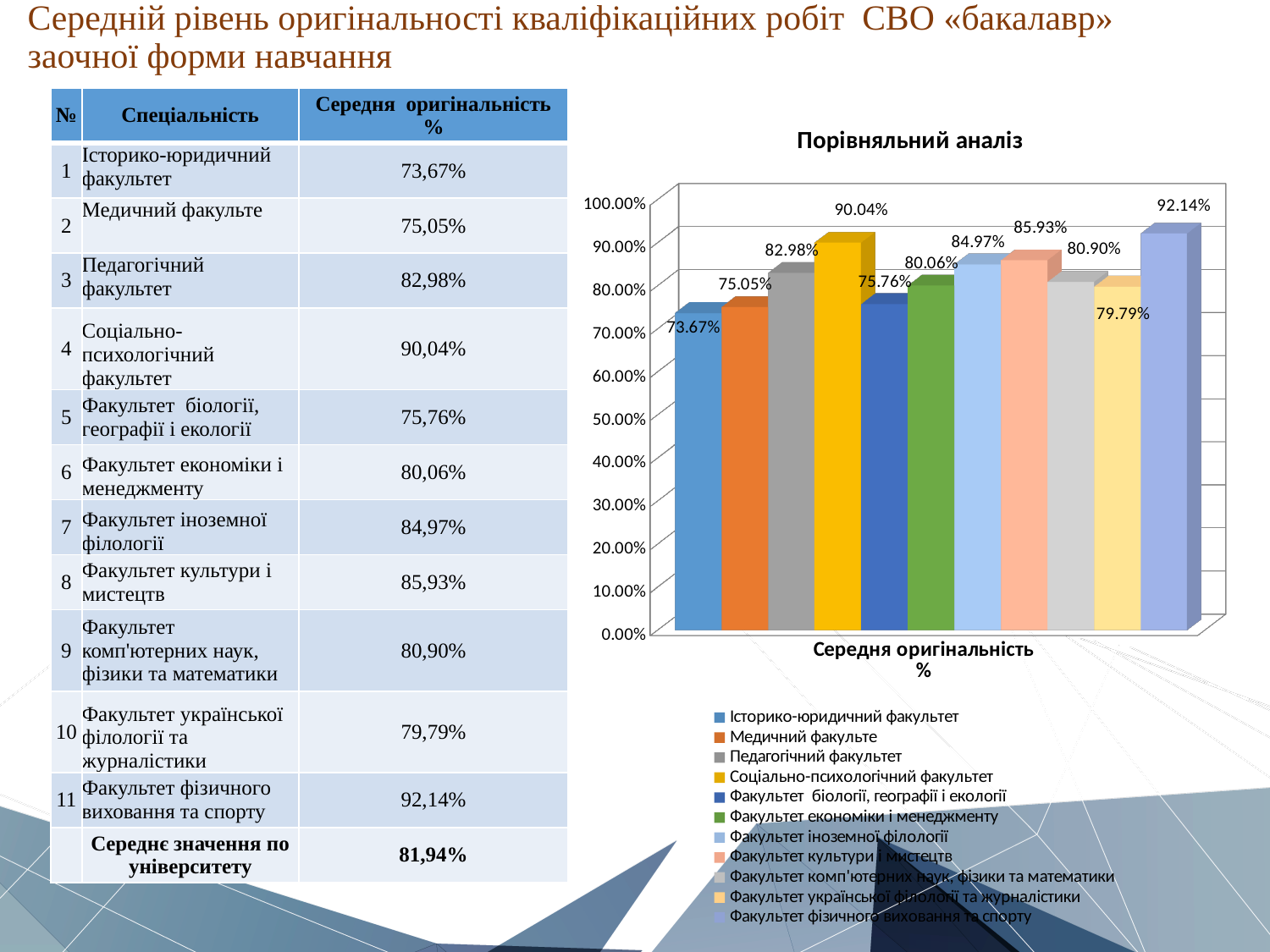
What is the value for Історико-юридичний факультет in the chart? 73.67% What is the difference between the values for Факультет фізичного виховання та спорту and Історико-юридичний факультет? 18.47% What is the title of the chart? Порівняльний аналіз Is the value for Факультет культури і мистецтв greater or less than 80.00%? greater How many series does the chart legend list? 11 Which faculty has the highest value in the chart? Факультет фізичного виховання та спорту What is the value for Факультет іноземної філології in the chart? 84.97% Which faculty has the lowest value in the chart? Історико-юридичний факультет What is the difference between the values for Соціально-психологічний факультет and Факультет української філології та журналістики? 10.25% What is the value for Соціально-психологічний факультет in the chart? 90.04% What type of chart is shown on the slide? bar chart Which is larger: the value for Педагогічний факультет or the value for Факультет економіки і менеджменту? Педагогічний факультет